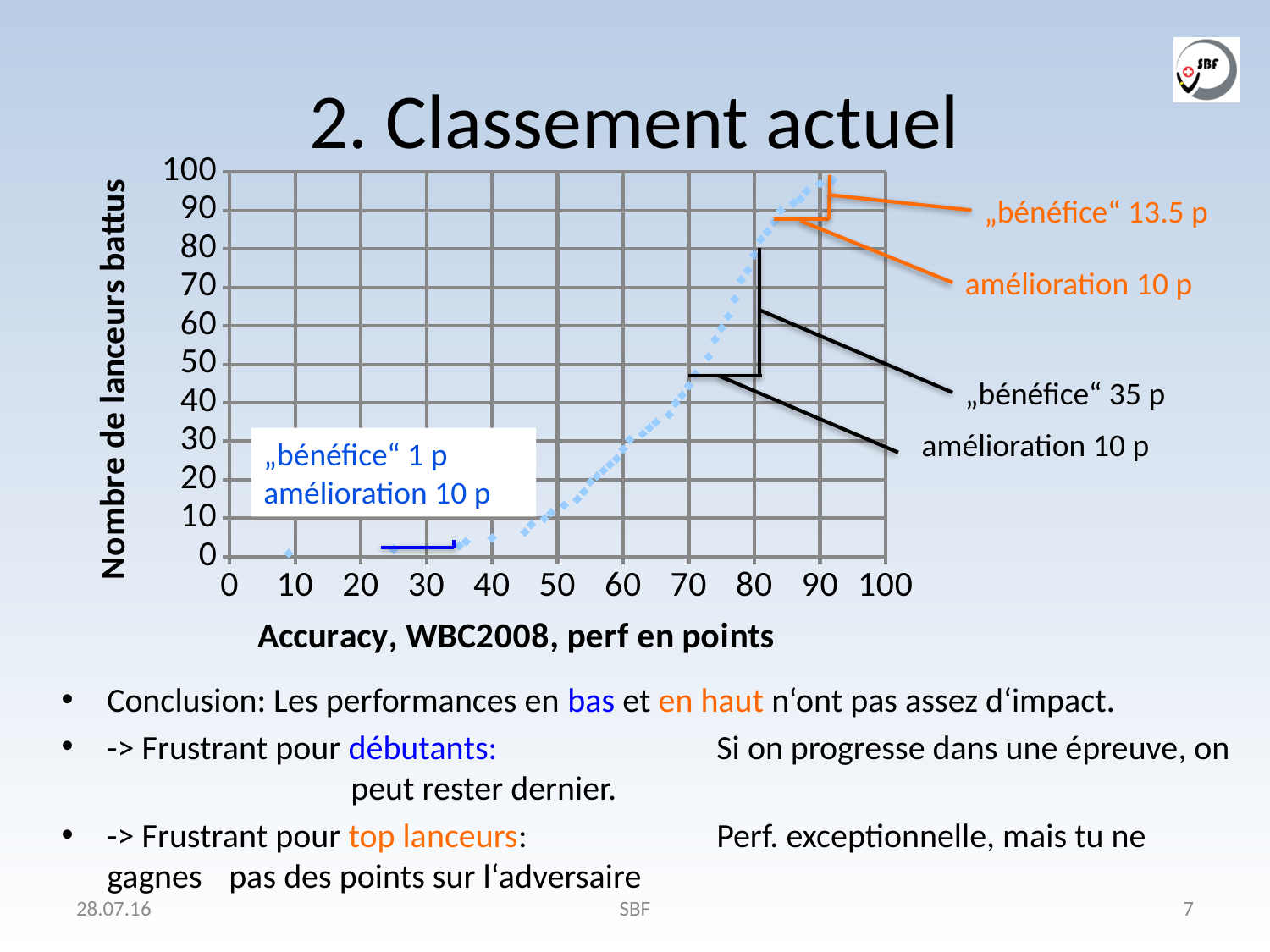
Which annotated "bénéfice" is larger: the black one (middle of the curve) or the orange one (top of the curve)? the black one, 35 p Is the plotted value at x = 40 greater or less than 20? less What is the title of the y axis of the chart? Nombre de lanceurs battus Do the plotted values rise or fall as the x axis increases from 0 to 100? rise According to the orange annotation, what is the "bénéfice" for an improvement of 10 points at the top of the curve? 13.5 p According to the black annotation, what is the "bénéfice" for an improvement of 10 points in the middle of the curve? 35 p What kind of chart is shown on the slide? scatter chart Is the plotted value at x = 90 greater or less than 80? greater Is the plotted value at x = 50 greater or less than 30? less What is the title of the x axis of the chart? Accuracy, WBC2008, perf en points According to the blue annotation, what is the "bénéfice" for an improvement of 10 points at the bottom of the curve? 1 p